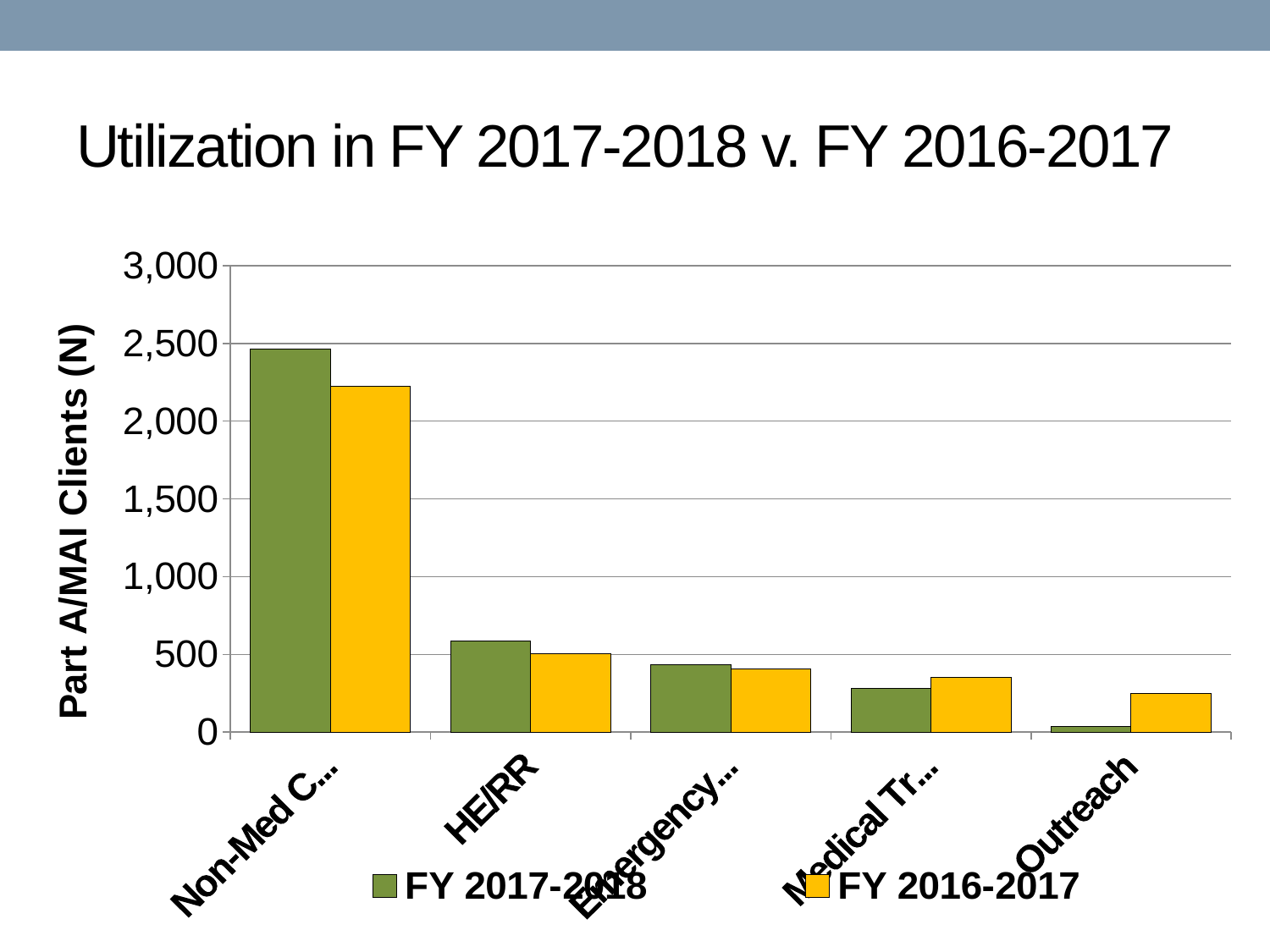
For HE/RR, which series has the larger value, FY 2017-2018 or FY 2016-2017? FY 2017-2018 For Outreach, which series has the larger value, FY 2017-2018 or FY 2016-2017? FY 2016-2017 How many series does the legend list? 2 How many categories are shown on the x axis? 5 What is the title of the y axis? Part A/MAI Clients (N) Is the FY 2017-2018 value for HE/RR greater or less than 500? greater Which category has the highest FY 2017-2018 value? Non-Med C... (the leftmost category) Which category has the lowest FY 2017-2018 value? Outreach Is the FY 2017-2018 value for the leftmost category greater or less than 2,000? greater Is the FY 2016-2017 value for Outreach greater or less than 500? less What kind of chart is shown on the slide? Bar chart Do the FY 2016-2017 values rise or fall from left to right across the categories? fall